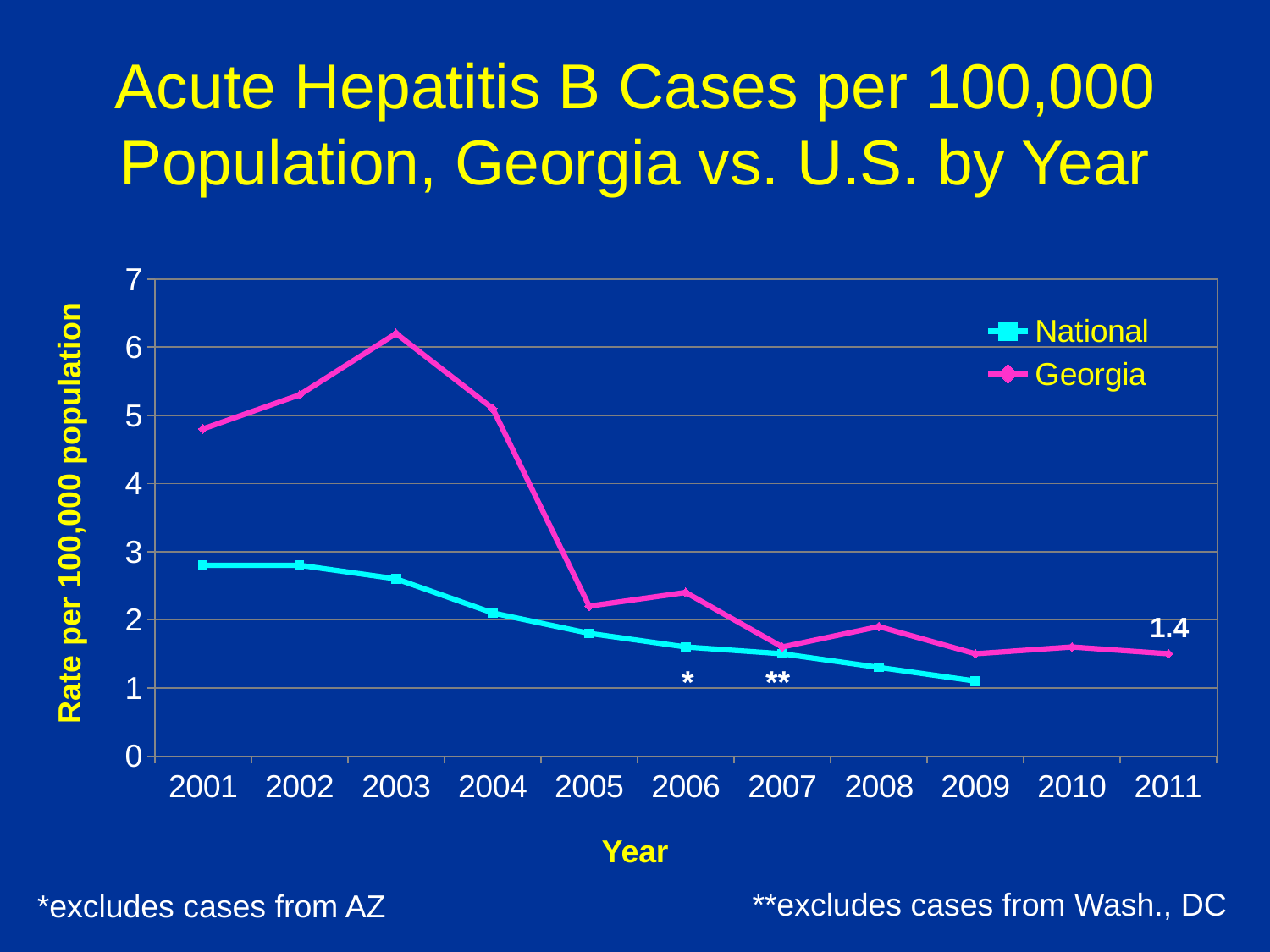
What is the label of the y axis? Rate per 100,000 population Is the Georgia value for 2005 greater or less than 3? less What is the Georgia rate per 100,000 population in 2011? 1.4 In which year is the Georgia rate highest? 2003 Does the National rate rise or fall from 2001 to 2009? fall Is the Georgia value for 2001 greater or less than 4? greater How many series does the legend list? 2 In 2008, which series has the higher rate, National or Georgia? Georgia What kind of chart is shown on the slide? line chart In 2003, which series has the higher rate, National or Georgia? Georgia Is the National value for 2005 greater or less than 2? less How many years are shown on the x axis? 11